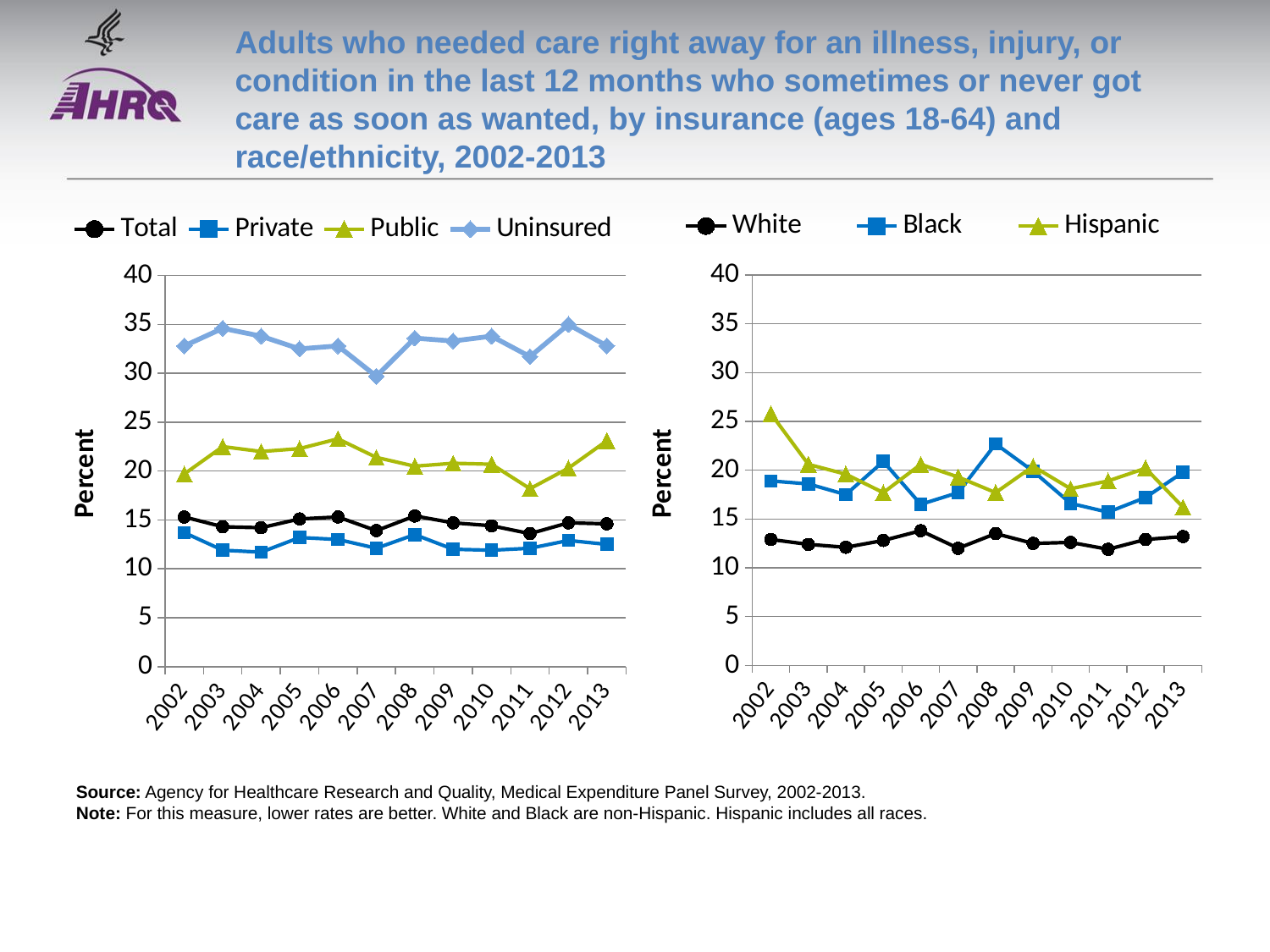
How many years are plotted along the x axis of the right chart (by race/ethnicity)? 12 In the right chart (by race/ethnicity), which is larger in 2013, Black or Hispanic? Black In the left chart (by insurance), is the value for Uninsured in 2012 greater or less than 30? greater What is the label on the y axis of the left chart (by insurance)? Percent In the left chart (by insurance), which series has the highest value in 2013? Uninsured How many series does the legend of the left chart (by insurance) list? 4 In the left chart (by insurance), is the value for Public in 2011 greater or less than 20? less In the right chart (by race/ethnicity), which series has the highest value in 2008? Black What kind of chart is the left chart (by insurance)? line chart In the right chart (by race/ethnicity), is the value for Hispanic in 2002 greater or less than 20? greater How many series does the legend of the right chart (by race/ethnicity) list? 3 In the left chart (by insurance), which series has the lowest value in 2003? Private